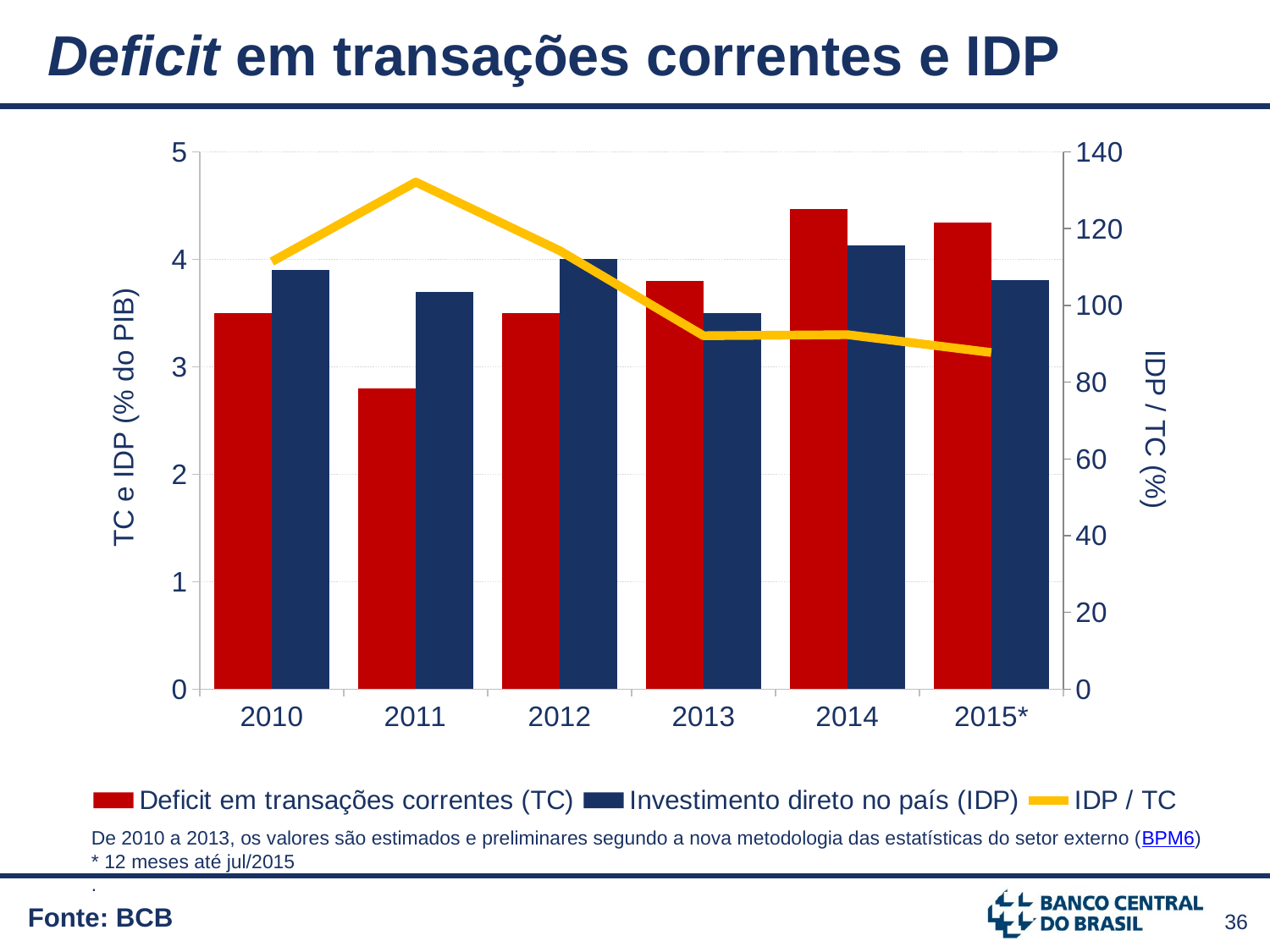
What kind of chart is shown on the slide? bar chart with a line In which year is the Deficit em transações correntes (TC) bar the highest? 2014 Is the Deficit em transações correntes (TC) value for 2011 greater or less than 3? less Is the Deficit em transações correntes (TC) value for 2014 greater or less than 4? greater In which year is the Deficit em transações correntes (TC) bar the lowest? 2011 How many years are shown on the x axis? 6 In 2010, which is larger: the Deficit em transações correntes (TC) bar or the Investimento direto no país (IDP) bar? Investimento direto no país (IDP) Is the IDP / TC value for 2011 greater or less than 120? greater In which year does the IDP / TC line reach its highest point? 2011 How many series does the legend list? 3 Does the IDP / TC line rise or fall from 2011 to 2015*? fall